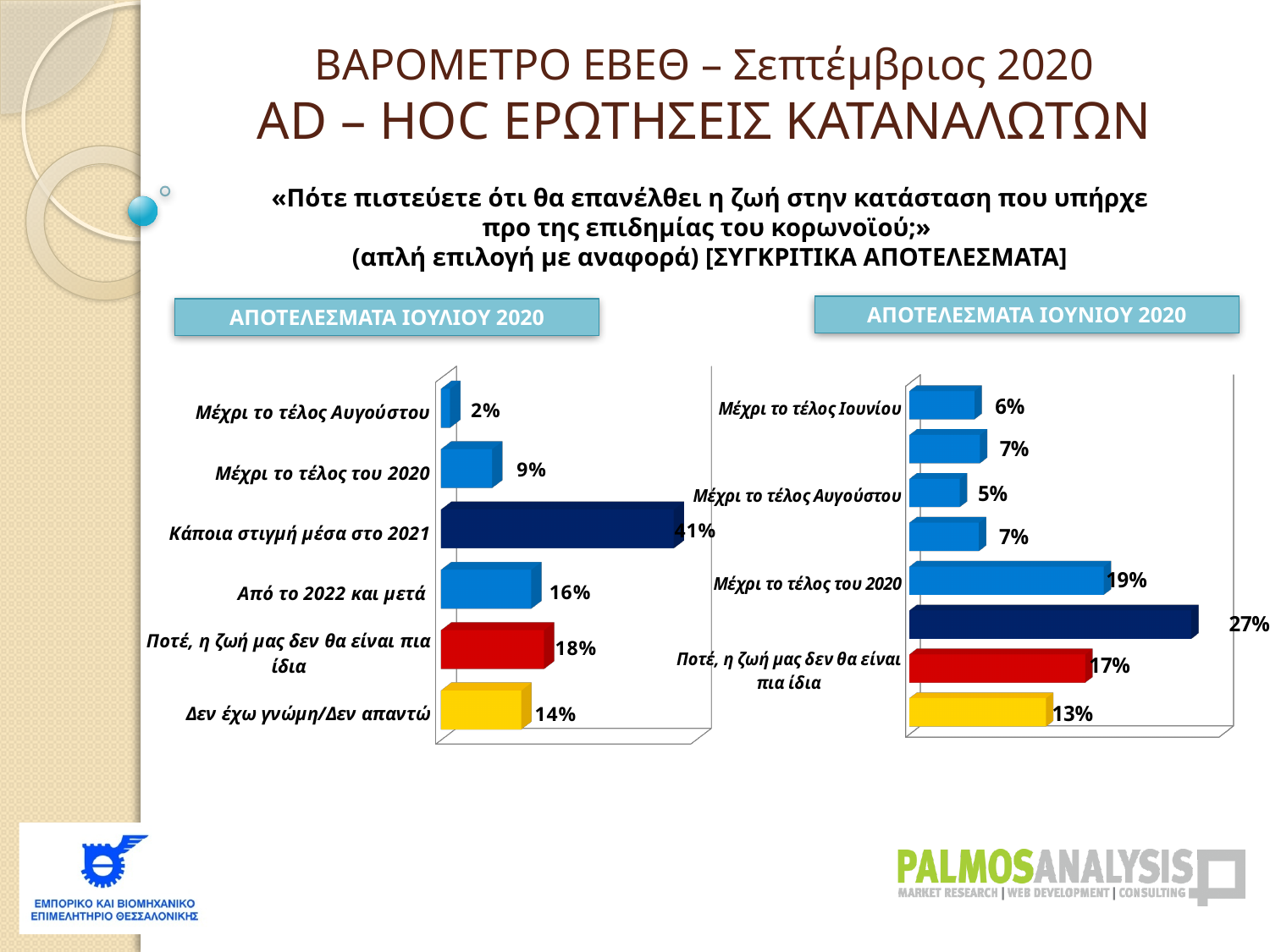
In the ΑΠΟΤΕΛΕΣΜΑΤΑ ΙΟΥΛΙΟΥ 2020 chart, what is the value for "Μέχρι το τέλος Αυγούστου"? 2% In the ΑΠΟΤΕΛΕΣΜΑΤΑ ΙΟΥΛΙΟΥ 2020 chart, which category has the highest value? Κάποια στιγμή μέσα στο 2021 In the ΑΠΟΤΕΛΕΣΜΑΤΑ ΙΟΥΛΙΟΥ 2020 chart, what is the difference between "Ποτέ, η ζωή μας δεν θα είναι πια ίδια" and "Δεν έχω γνώμη/Δεν απαντώ"? 4% How many bars are shown in the ΑΠΟΤΕΛΕΣΜΑΤΑ ΙΟΥΝΙΟΥ 2020 chart? 8 In the ΑΠΟΤΕΛΕΣΜΑΤΑ ΙΟΥΝΙΟΥ 2020 chart, what is the value for "Ποτέ, η ζωή μας δεν θα είναι πια ίδια"? 17% What type of chart is the ΑΠΟΤΕΛΕΣΜΑΤΑ ΙΟΥΝΙΟΥ 2020 chart? Bar chart In the ΑΠΟΤΕΛΕΣΜΑΤΑ ΙΟΥΛΙΟΥ 2020 chart, which category has the lowest value? Μέχρι το τέλος Αυγούστου In the ΑΠΟΤΕΛΕΣΜΑΤΑ ΙΟΥΛΙΟΥ 2020 chart, what is the value for "Κάποια στιγμή μέσα στο 2021"? 41% In the ΑΠΟΤΕΛΕΣΜΑΤΑ ΙΟΥΝΙΟΥ 2020 chart, what is the value for "Μέχρι το τέλος του 2020"? 19% In the ΑΠΟΤΕΛΕΣΜΑΤΑ ΙΟΥΛΙΟΥ 2020 chart, which is larger: "Από το 2022 και μετά" or "Μέχρι το τέλος του 2020"? Από το 2022 και μετά How many categories are shown in the ΑΠΟΤΕΛΕΣΜΑΤΑ ΙΟΥΛΙΟΥ 2020 chart? 6 In the ΑΠΟΤΕΛΕΣΜΑΤΑ ΙΟΥΝΙΟΥ 2020 chart, what is the highest value shown on any bar? 27%